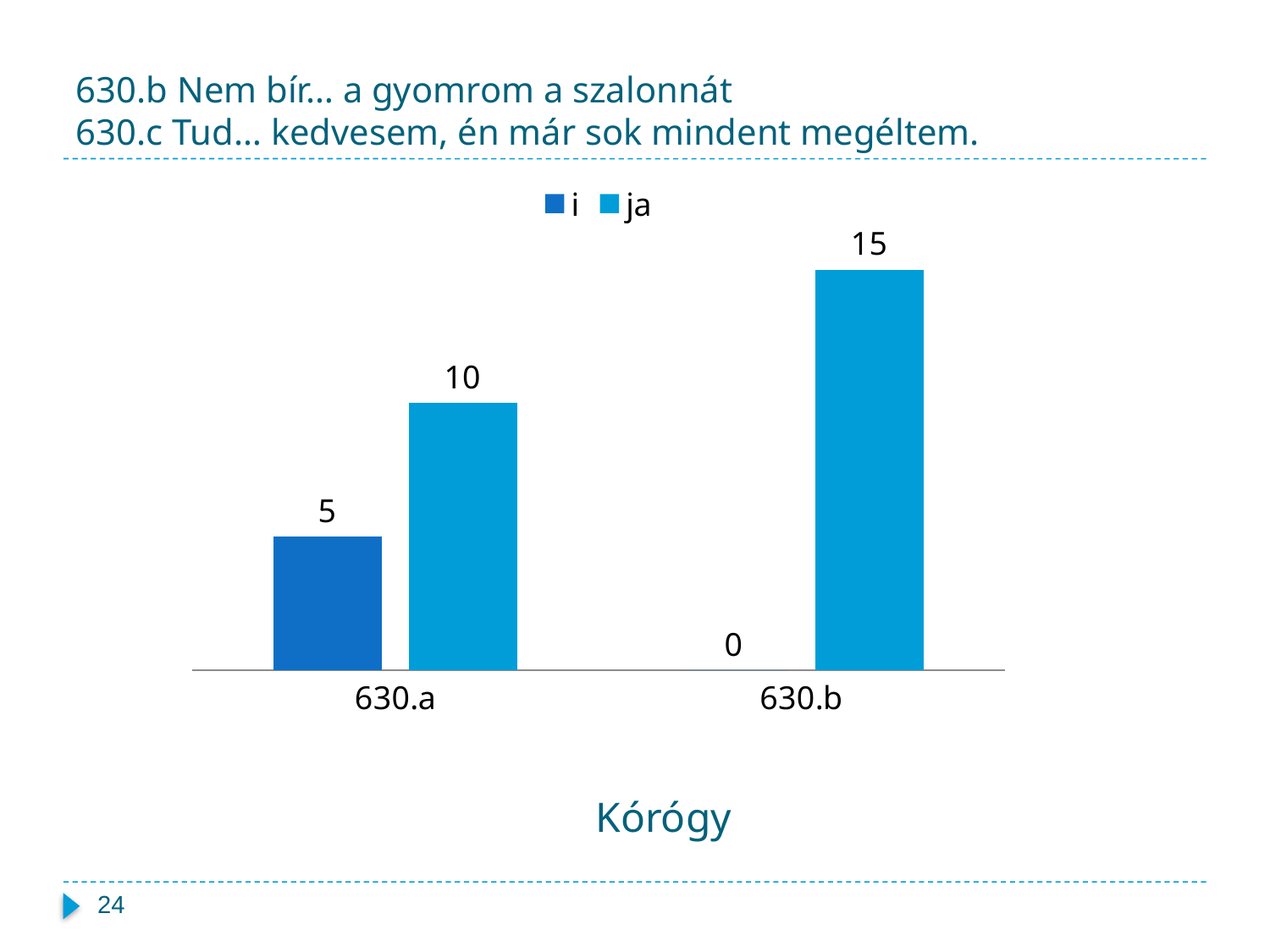
How many categories are shown on the x axis? 2 Which category has the highest value for series "ja"? 630.b What is the value for series "ja" in category 630.a? 10 What is the value for series "i" in category 630.b? 0 Which category has the lowest value for series "i"? 630.b How many series does the legend list? 2 What is the value for series "ja" in category 630.b? 15 What is the difference between the "ja" values for 630.b and 630.a? 5 In category 630.a, which series has the larger value, "i" or "ja"? ja What are the names of the series listed in the legend? i and ja What is the value for series "i" in category 630.a? 5 What kind of chart is shown on the slide? bar chart